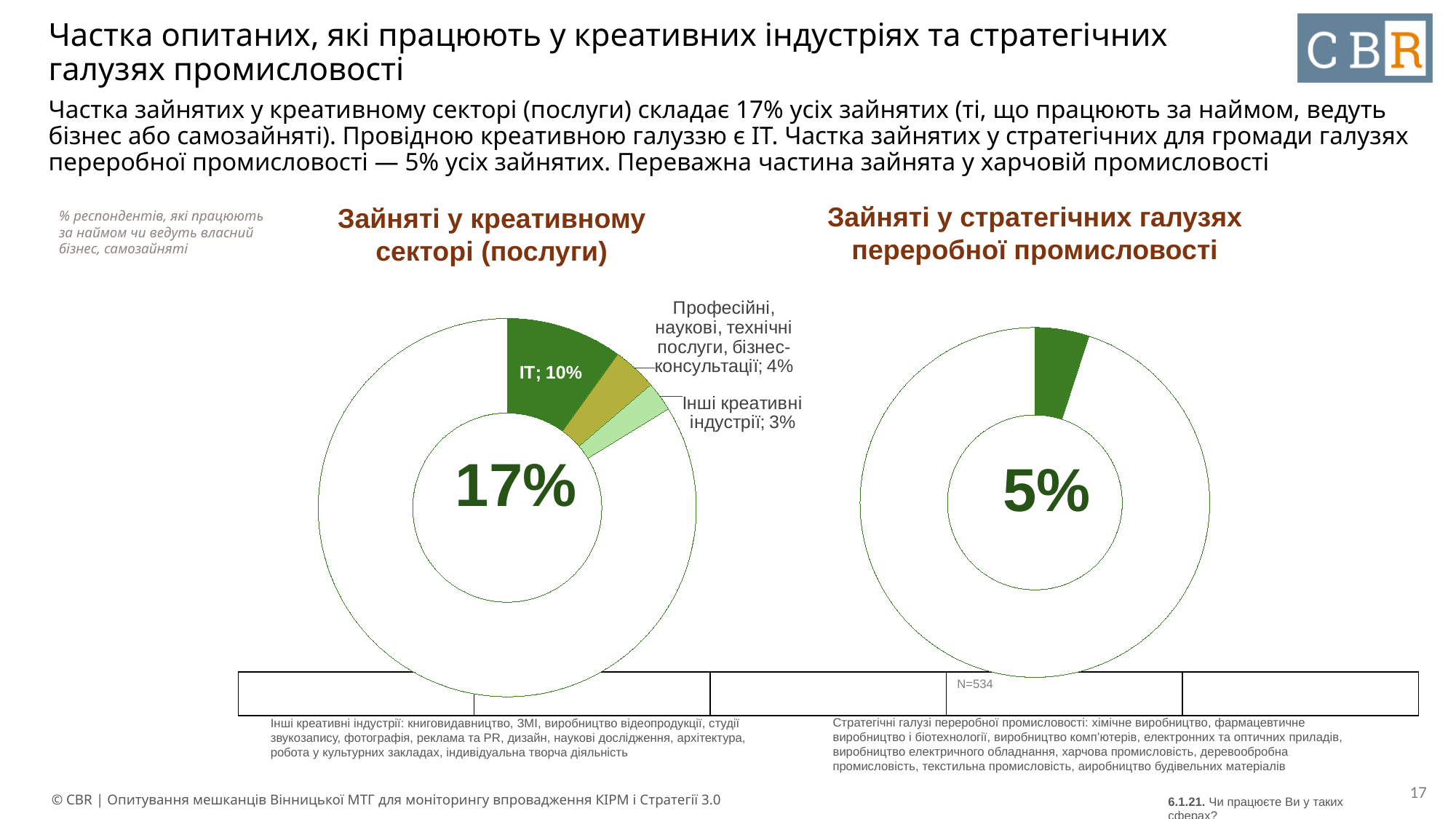
On the left chart 'Зайняті у креативному секторі (послуги)', which is larger: IT or 'Професійні, наукові, технічні послуги, бізнес-консультації'? IT On the left chart 'Зайняті у креативному секторі (послуги)', what is the value for IT? 10% What kind of chart is the right chart 'Зайняті у стратегічних галузях переробної промисловості'? Donut (pie) chart On the right chart 'Зайняті у стратегічних галузях переробної промисловості', what percentage is shown in the centre of the donut? 5% On the left chart 'Зайняті у креативному секторі (послуги)', what is the value for 'Професійні, наукові, технічні послуги, бізнес-консультації'? 4% On the left chart 'Зайняті у креативному секторі (послуги)', what is the difference between the IT value and the 'Інші креативні індустрії' value? 7% On the left chart 'Зайняті у креативному секторі (послуги)', what total percentage is shown in the centre of the donut? 17% On the left chart 'Зайняті у креативному секторі (послуги)', what is the value for 'Інші креативні індустрії'? 3% On the left chart 'Зайняті у креативному секторі (послуги)', which labelled segment has the highest value? IT What is the difference between the centre value of the left chart (17%) and the centre value of the right chart (5%)? 12% How many labelled segments does the left chart 'Зайняті у креативному секторі (послуги)' have? 3 On the left chart 'Зайняті у креативному секторі (послуги)', which labelled segment has the lowest value? Інші креативні індустрії